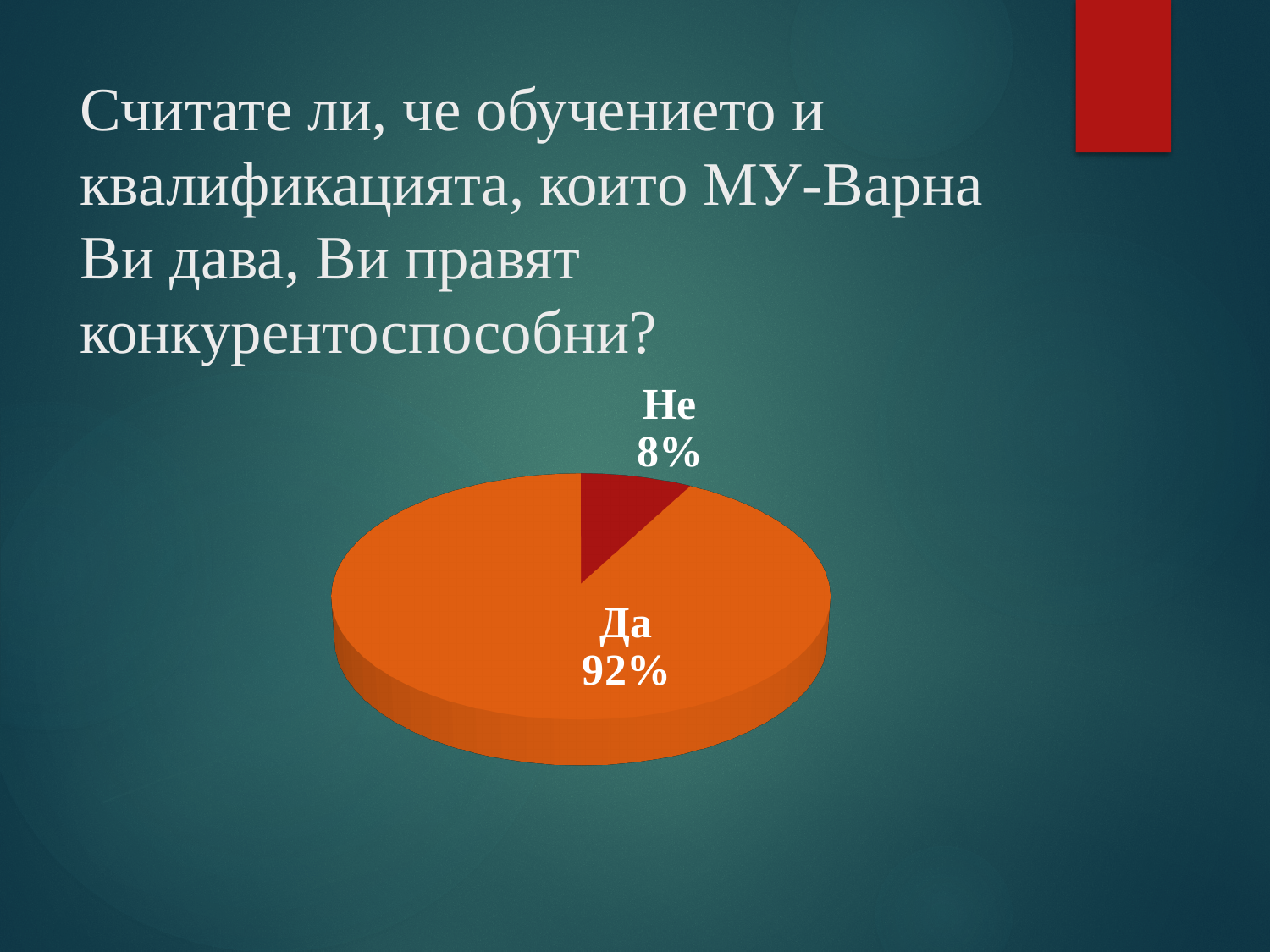
Which slice of the pie is the largest? Да What share of the pie does the "Да" slice represent? 92% What kind of chart is shown on the slide? Pie chart What colour is the "Да" slice of the pie? Orange Which slice of the pie is the smallest? Не What colour is the "Не" slice of the pie? Dark red How many slices does the pie chart have? 2 What share of the pie does the "Не" slice represent? 8% Which is larger, the "Да" slice or the "Не" slice? Да What is the total of the two slices shown in the pie chart? 100% What is the difference in percentage points between the "Да" and "Не" slices? 84 percentage points